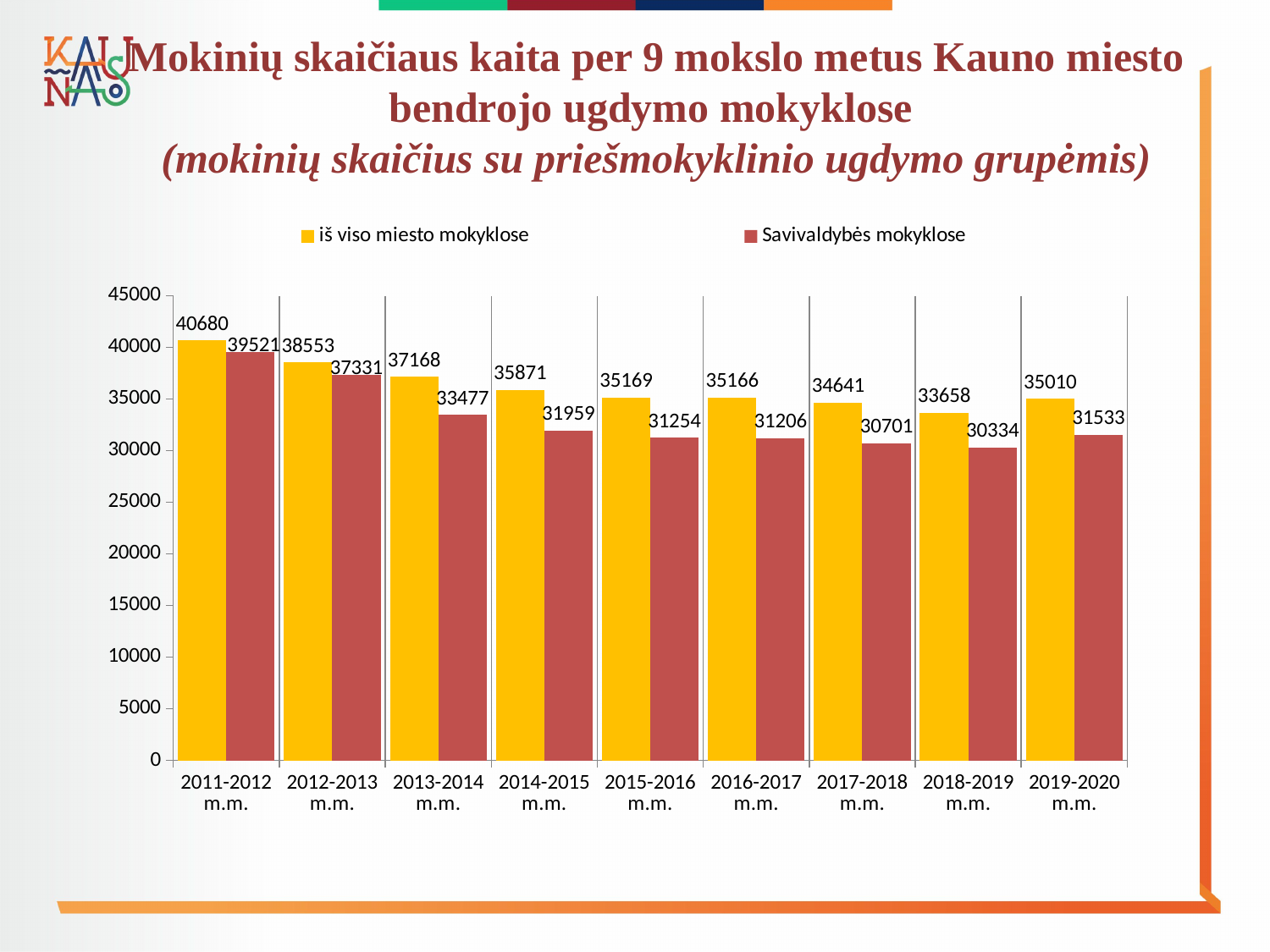
What is the value for 'iš viso miesto mokyklose' in 2011-2012 m.m.? 40680 What is the value for 'Savivaldybės mokyklose' in 2014-2015 m.m.? 31959 Is the value for 'Savivaldybės mokyklose' in 2018-2019 m.m. greater or less than 35000? less What is the difference between 'iš viso miesto mokyklose' and 'Savivaldybės mokyklose' in 2017-2018 m.m.? 3940 Which school year has the lowest value for 'iš viso miesto mokyklose'? 2018-2019 m.m. Which school year has the highest value for 'Savivaldybės mokyklose'? 2011-2012 m.m. Which colour represents 'Savivaldybės mokyklose' in the chart? red How many school years are shown on the x axis? 9 How many series does the legend list? 2 What is the value for 'Savivaldybės mokyklose' in 2019-2020 m.m.? 31533 What kind of chart is shown on the slide? bar chart Which is larger: 'iš viso miesto mokyklose' in 2012-2013 m.m. or in 2013-2014 m.m.? 2012-2013 m.m.